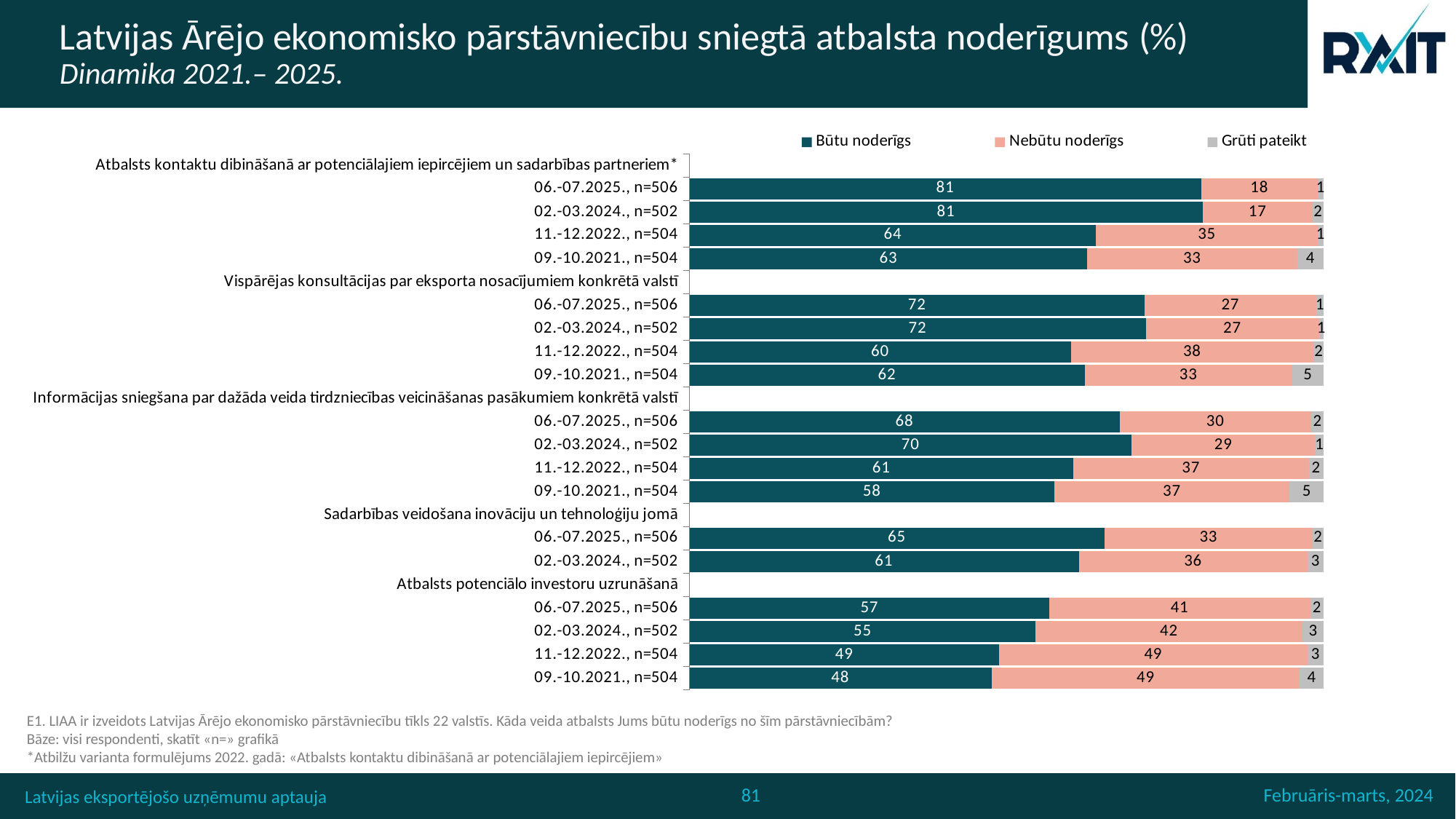
Which is larger for 'Sadarbības veidošana inovāciju un tehnoloģiju jomā': the 'Būtu noderīgs' value in 06.-07.2025., n=506 or in 02.-03.2024., n=502? 06.-07.2025., n=506 What is the total of the stacked bar for 'Vispārējas konsultācijas par eksporta nosacījumiem konkrētā valstī' in 11.-12.2022., n=504? 100 What is the 'Grūti pateikt' value for 'Vispārējas konsultācijas par eksporta nosacījumiem konkrētā valstī' in 09.-10.2021., n=504? 5 What kind of chart is shown on the slide? stacked bar chart What is the difference between the 'Būtu noderīgs' values for 'Atbalsts kontaktu dibināšanā ar potenciālajiem iepircējiem un sadarbības partneriem' in 06.-07.2025., n=506 and in 09.-10.2021., n=504? 18 Within 'Atbalsts potenciālo investoru uzrunāšanā', which survey wave has the lowest 'Būtu noderīgs' value? 09.-10.2021., n=504 How does the 'Būtu noderīgs' value for 'Atbalsts potenciālo investoru uzrunāšanā' change from 09.-10.2021. to 06.-07.2025.? rises What is the 'Nebūtu noderīgs' value for 'Atbalsts potenciālo investoru uzrunāšanā' in 02.-03.2024., n=502? 42 Which legend entry is shown in grey? Grūti pateikt How many series does the legend list? 3 Within 'Informācijas sniegšana par dažāda veida tirdzniecības veicināšanas pasākumiem konkrētā valstī', which survey wave has the highest 'Būtu noderīgs' value? 02.-03.2024., n=502 What is the 'Būtu noderīgs' value for 'Atbalsts kontaktu dibināšanā ar potenciālajiem iepircējiem un sadarbības partneriem' in 06.-07.2025., n=506? 81